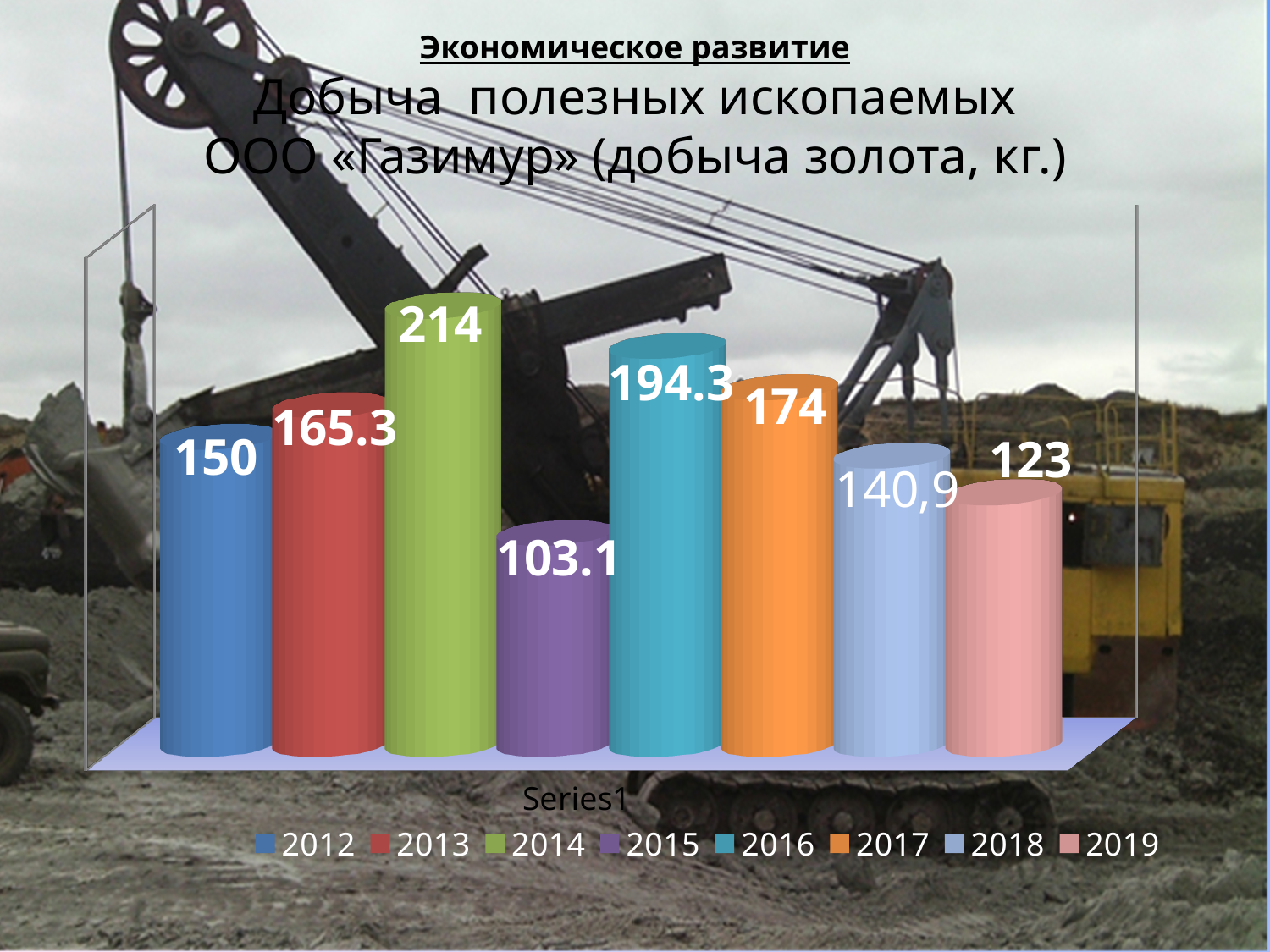
What is the value shown for 2016? 194.3 What kind of chart is shown on the slide? Bar chart Which year has the lowest value on the chart? 2015 Which year has the highest value on the chart? 2014 Which is larger, the value for 2013 or the value for 2017? 2017 What is the value shown for 2018? 140,9 What is the difference between the values for 2017 and 2019? 51 What is the value shown for 2015? 103.1 How many years (bars) are shown on the chart? 8 What is the difference between the values for 2014 and 2012? 64 What is the gold production value shown for 2014? 214 How many entries does the legend list? 8